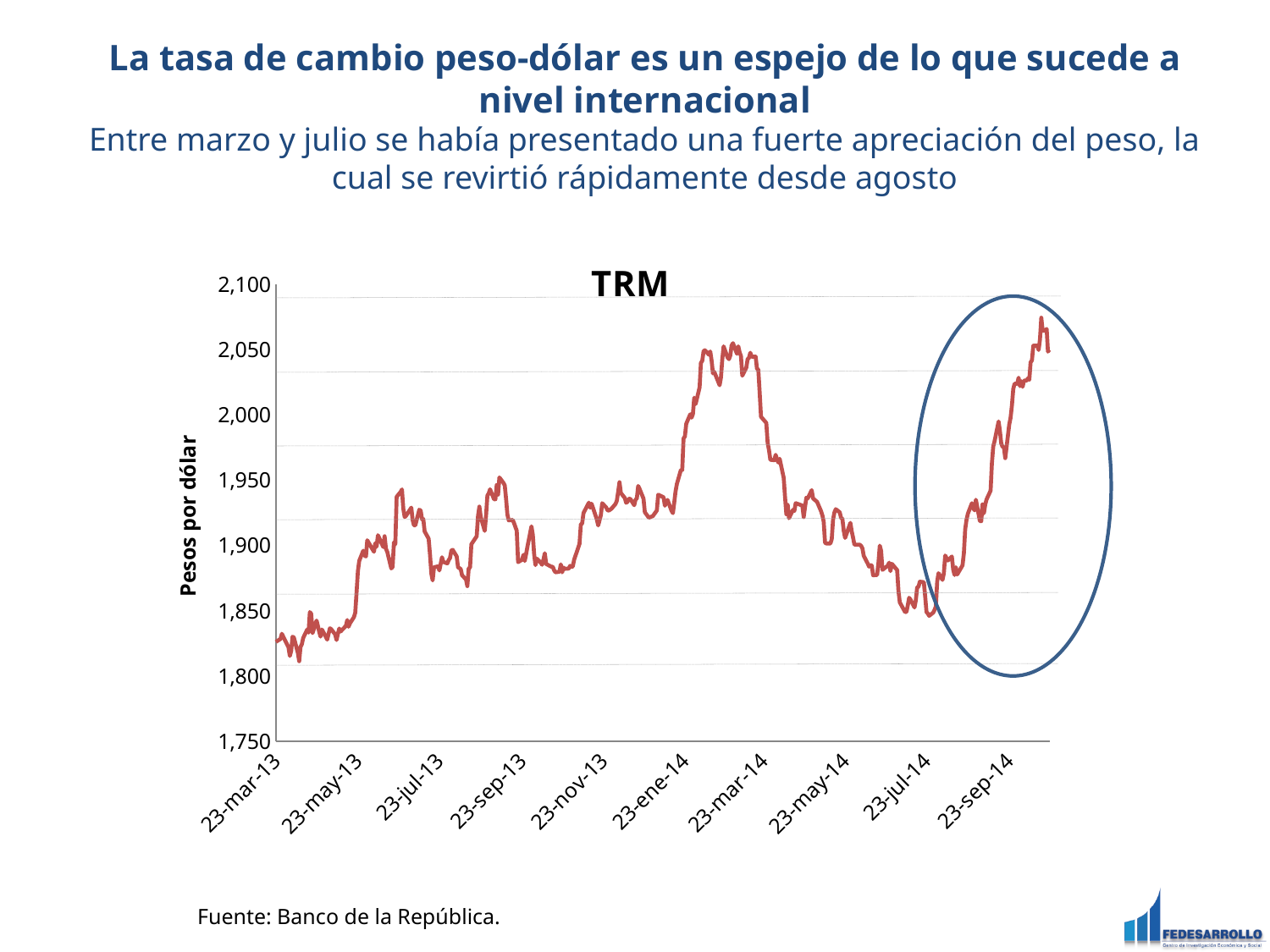
Does the TRM rise or fall between 23-jul-14 and 23-sep-14? rise Is the highest value reached by the TRM line greater or less than 2,050? greater Does the TRM rise or fall between 23-mar-14 and 23-jul-14? fall Is the value of the TRM at 23-nov-13 greater or less than 2,000? less What is the label of the vertical axis? Pesos por dólar How many date labels are shown on the horizontal axis? 10 Is the value of the TRM at 23-mar-13 greater or less than 1,850? less What kind of chart is shown on the slide? line chart What is the title of the chart? TRM